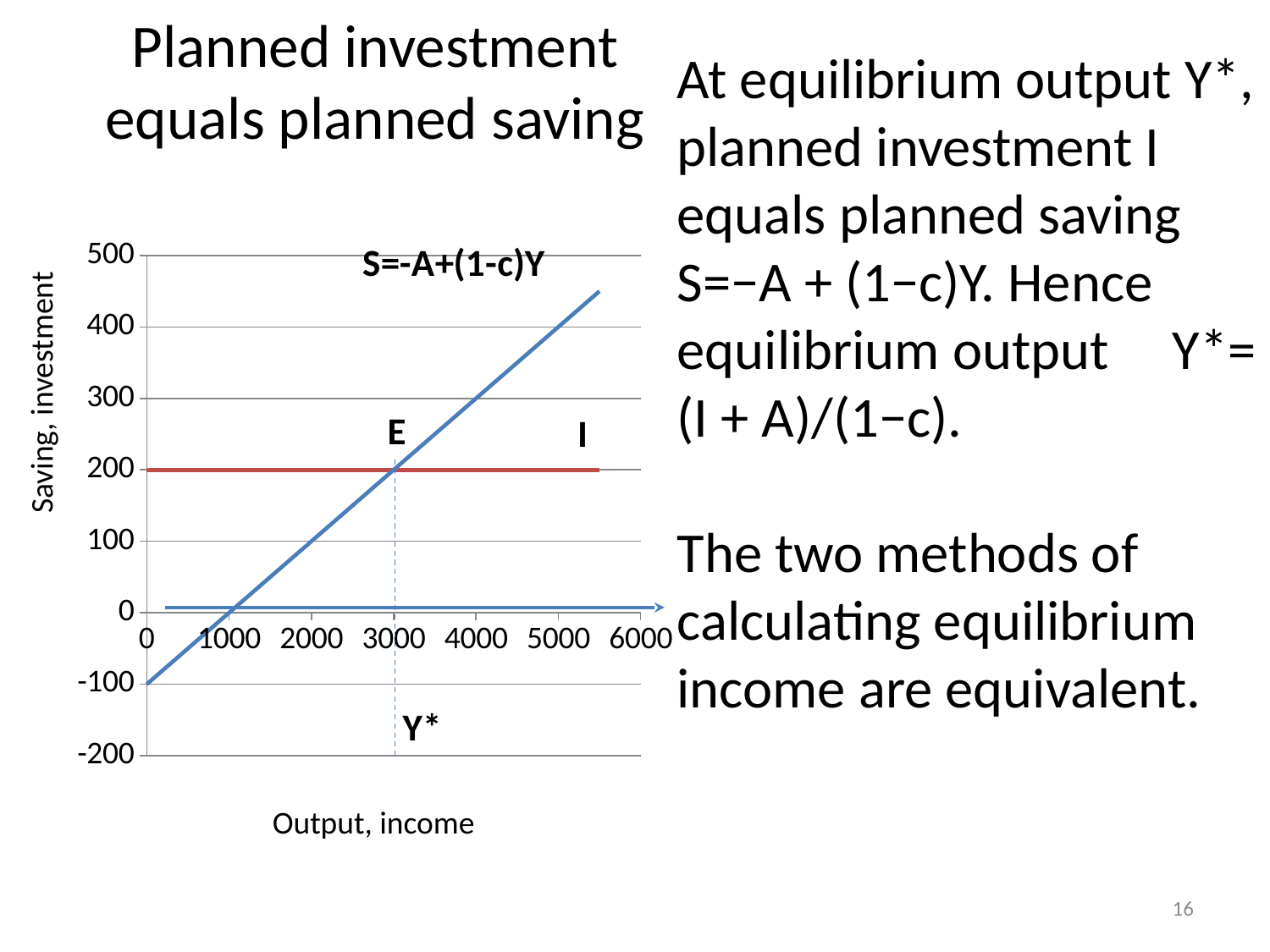
At an output of 5000, which is higher: the saving line S=-A+(1-c)Y or the investment line I? the saving line S=-A+(1-c)Y At what level of saving/investment does the horizontal line labelled I sit? 200 At an output of 5000, is the saving line S=-A+(1-c)Y greater or less than 300? greater What is the title of the chart? S=-A+(1-c)Y Does the saving line S=-A+(1-c)Y rise or fall as output increases? rise What is the value of the saving line S=-A+(1-c)Y when output is 0? -100 At an output of 2000, is the saving line S=-A+(1-c)Y greater or less than 200? less What is the label of the vertical axis? Saving, investment At an output of 1000, which is higher: the investment line I or the saving line S=-A+(1-c)Y? the investment line I At what level of output does the dashed line marking Y* meet the horizontal axis? 3000 What kind of chart is shown on the slide? line chart What is the highest value shown on the vertical axis? 500